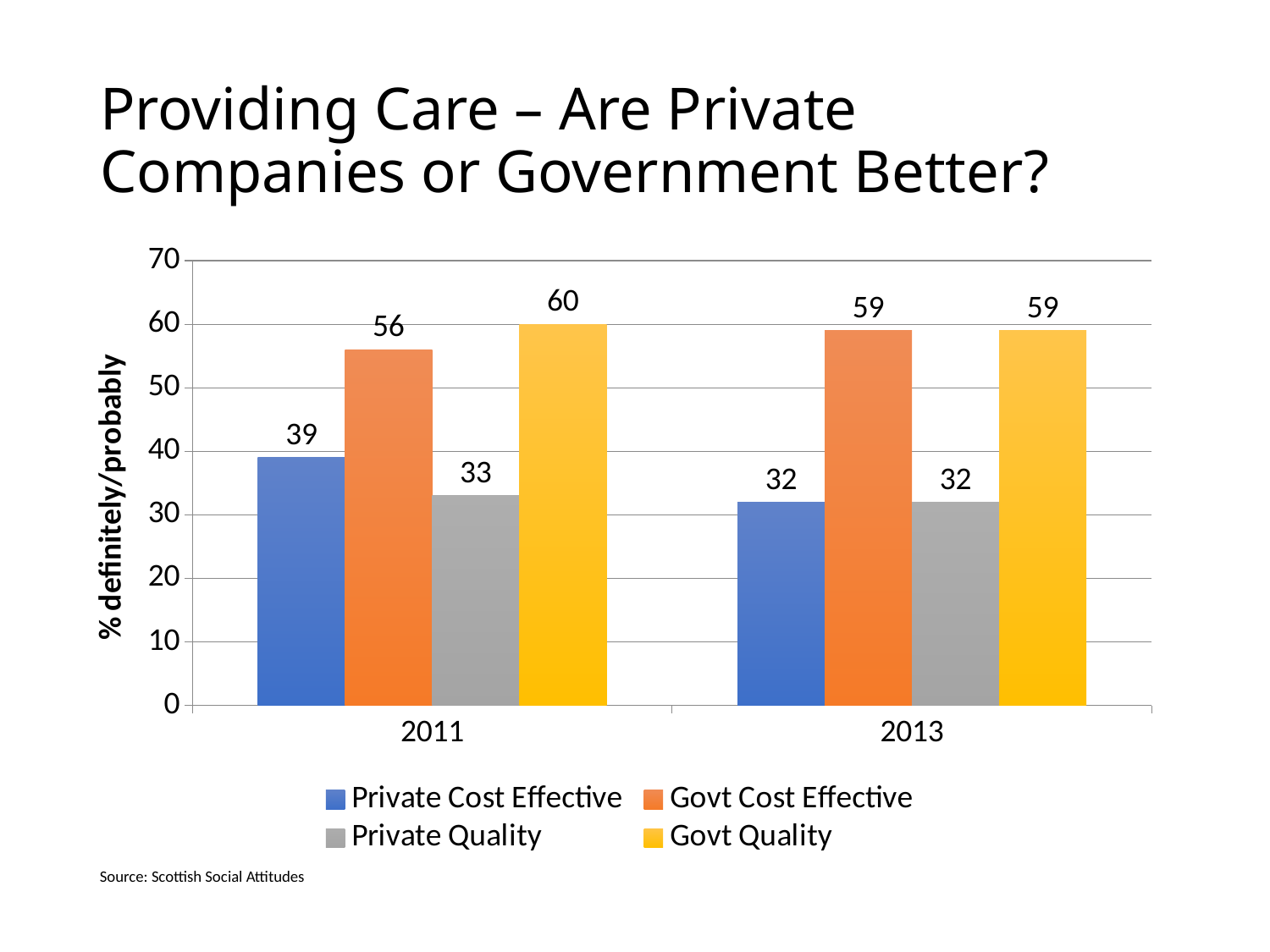
What kind of chart is shown on the slide? Bar chart Which series has the lowest value in 2011? Private Quality What is the value for Govt Quality in 2013? 59 What is the value for Private Quality in 2011? 33 What is the difference between Govt Cost Effective and Private Cost Effective in 2013? 27 How many year categories are shown on the x axis? 2 What is the label on the vertical axis? % definitely/probably Which series has the highest value in 2011? Govt Quality What is the value for Private Cost Effective in 2011? 39 How many series does the legend list? 4 Which is larger in 2011: Govt Cost Effective or Private Cost Effective? Govt Cost Effective Does the value for Private Cost Effective rise or fall from 2011 to 2013? Fall